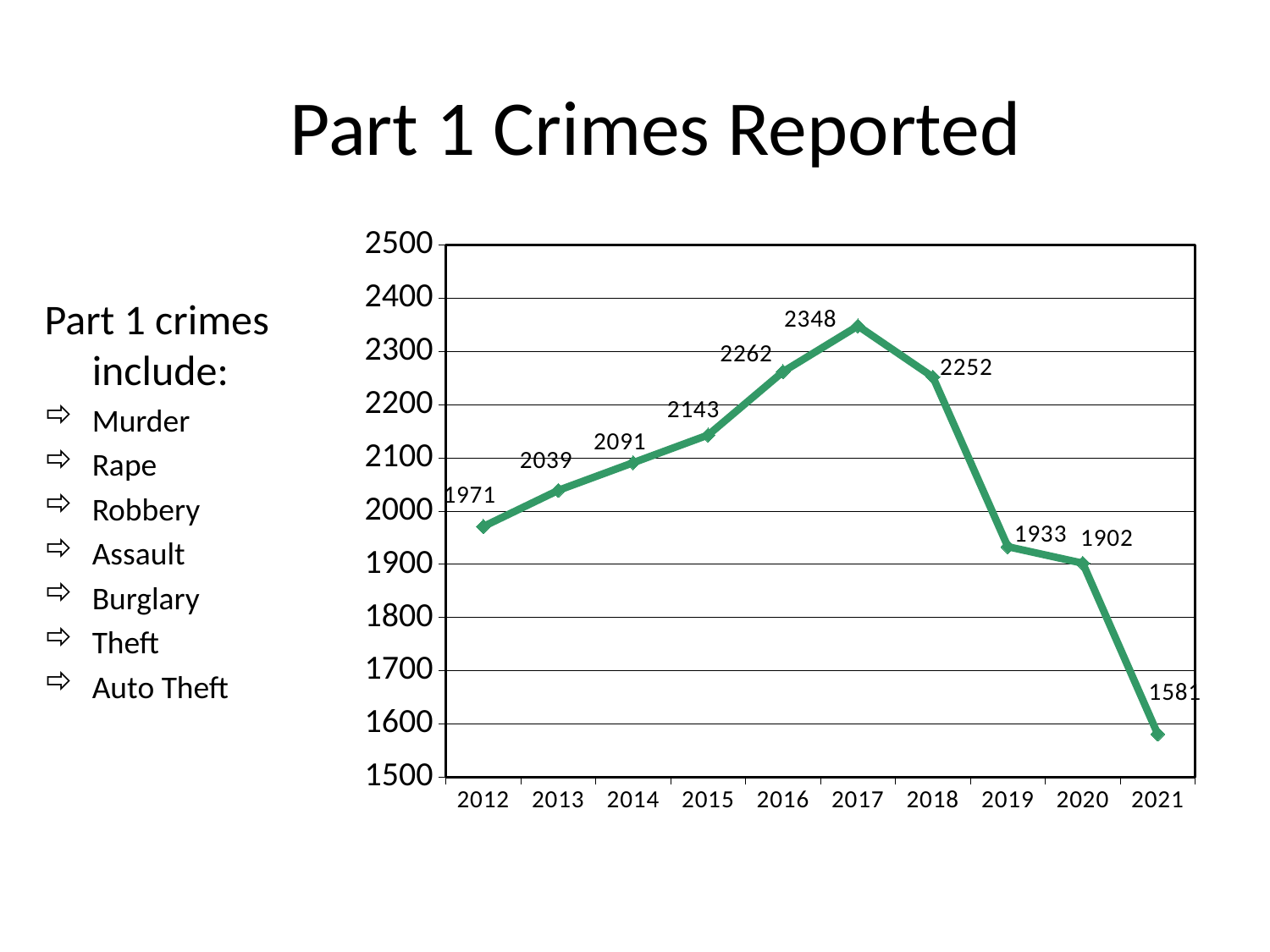
What is the difference between the values for 2020 and 2021? 321 What value is shown for 2021? 1581 What value is shown for 2017? 2348 What kind of chart is shown on the slide? line chart Which year has the highest value? 2017 What is the difference between the values for 2017 and 2018? 96 Do the values rise or fall from 2012 to 2017? rise What value is shown for 2012? 1971 Which year has the lowest value? 2021 Which is larger, the value for 2016 or the value for 2018? 2016 What value is shown for 2019? 1933 How many years are plotted on the chart? 10